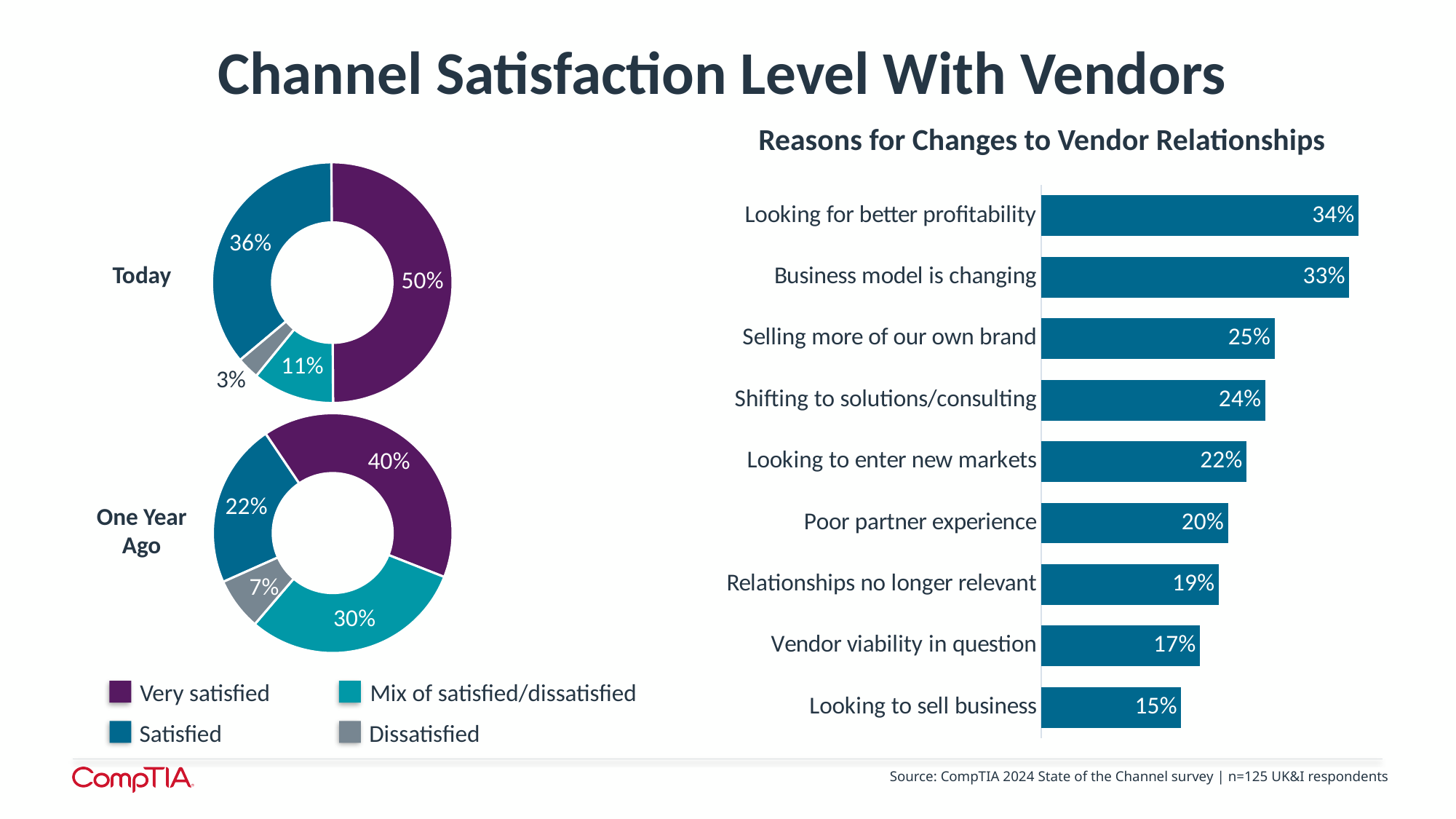
In the 'Today' donut chart, what percentage is Dissatisfied? 3% In the 'Reasons for Changes to Vendor Relationships' chart, what is the value for Poor partner experience? 20% In the 'Reasons for Changes to Vendor Relationships' chart, which reason has the lowest value? Looking to sell business In the 'One Year Ago' donut chart, what percentage is Mix of satisfied/dissatisfied? 30% What is the difference between the Very satisfied share Today and One Year Ago? 10% In the 'Reasons for Changes to Vendor Relationships' chart, what is the difference between Selling more of our own brand and Vendor viability in question? 8% In the 'Reasons for Changes to Vendor Relationships' chart, which reason has the highest value? Looking for better profitability What kind of chart is 'Reasons for Changes to Vendor Relationships'? Bar chart In the 'Today' donut chart, what percentage is Very satisfied? 50% In the 'One Year Ago' donut chart, which category has the smallest share? Dissatisfied How many categories does the legend for the donut charts list? 4 In the 'Reasons for Changes to Vendor Relationships' chart, how many reasons are listed? 9